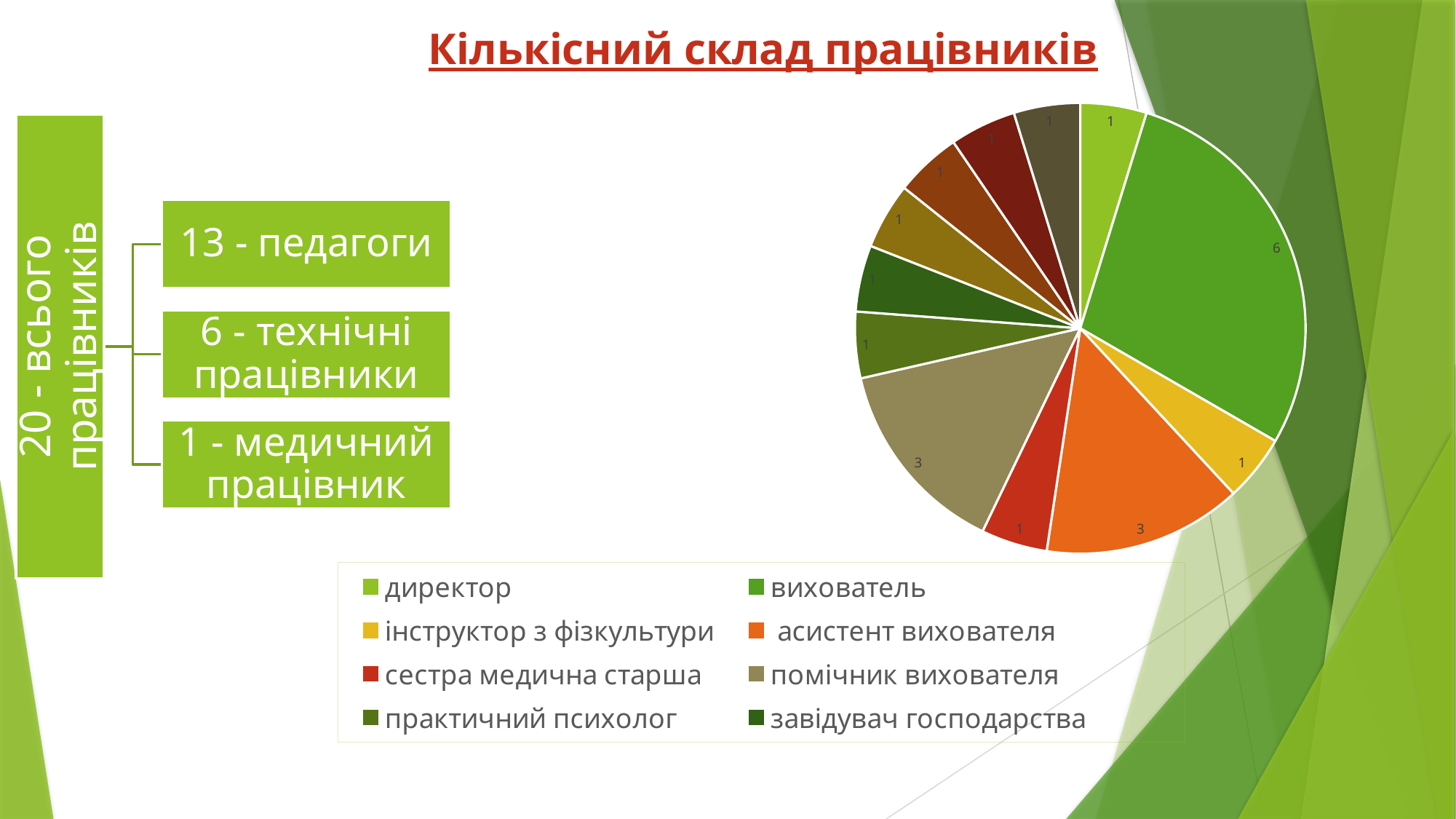
What is the value for помічник вихователя in the pie chart? 3 How many entries does the chart legend list? 8 How many slices does the pie chart have? 12 What is the value for директор in the pie chart? 1 What kind of chart is shown on the slide? pie chart Which category has the largest slice in the pie chart? вихователь What is the value for асистент вихователя in the pie chart? 3 What is the value for вихователь in the pie chart? 6 Which is larger, the value for асистент вихователя or the value for сестра медична старша? асистент вихователя What is the title of the chart on the slide? Кількісний склад працівників What is the difference between the values for вихователь and асистент вихователя? 3